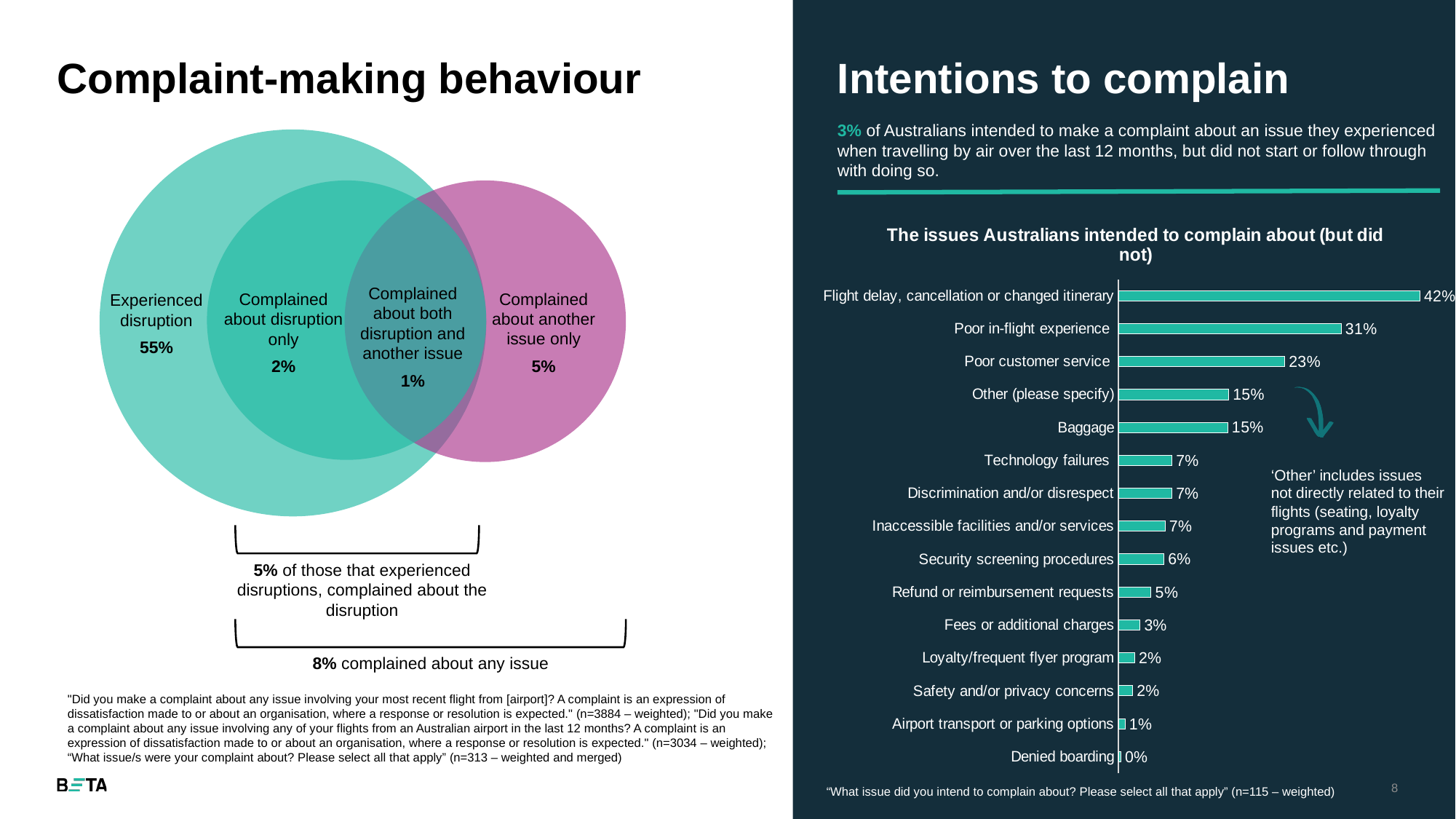
In the bar chart 'The issues Australians intended to complain about (but did not)', what is the value for Flight delay, cancellation or changed itinerary? 42% In the bar chart 'The issues Australians intended to complain about (but did not)', what is the value for Airport transport or parking options? 1% In the bar chart 'The issues Australians intended to complain about (but did not)', which issue has the lowest value? Denied boarding In the bar chart 'The issues Australians intended to complain about (but did not)', what is the difference between Poor in-flight experience and Poor customer service? 8% What kind of chart is 'The issues Australians intended to complain about (but did not)'? Bar chart In the Venn diagram on the left of the slide, what percentage experienced disruption? 55% How many issues are listed in the bar chart 'The issues Australians intended to complain about (but did not)'? 15 In the bar chart 'The issues Australians intended to complain about (but did not)', what is the value for Poor customer service? 23% In the bar chart 'The issues Australians intended to complain about (but did not)', which issue has the highest value? Flight delay, cancellation or changed itinerary In the Venn diagram on the left of the slide, what percentage complained about another issue only? 5% In the bar chart 'The issues Australians intended to complain about (but did not)', which is larger: Security screening procedures or Refund or reimbursement requests? Security screening procedures In the bar chart 'The issues Australians intended to complain about (but did not)', what is the value for Baggage? 15%